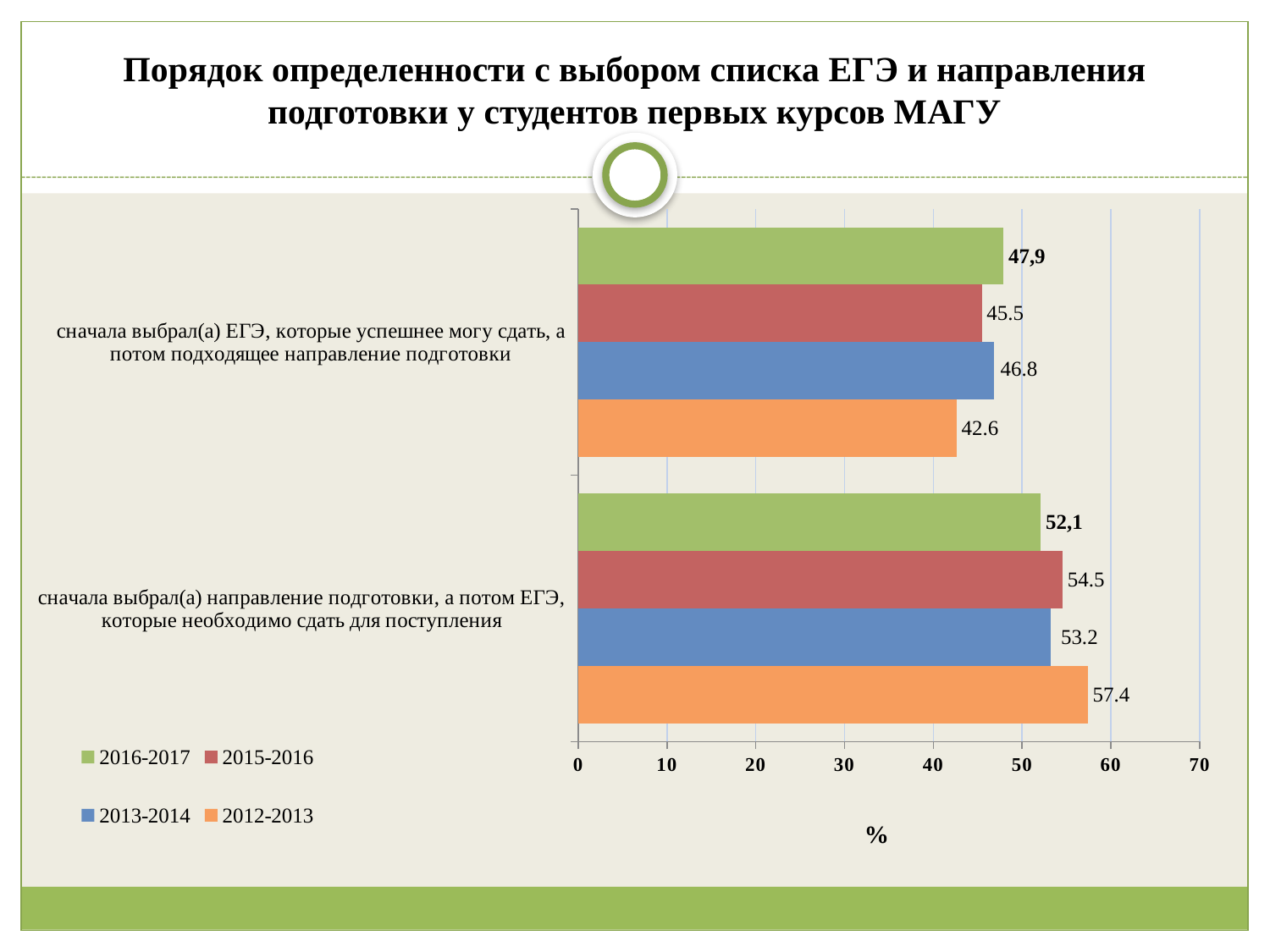
What kind of chart is shown on the slide? bar chart What is the value for 2016-2017 in the category "сначала выбрал(а) ЕГЭ, которые успешнее могу сдать, а потом подходящее направление подготовки"? 47,9 Which series has the highest value in the category "сначала выбрал(а) направление подготовки, а потом ЕГЭ, которые необходимо сдать для поступления"? 2012-2013 How many categories are shown on the vertical axis? 2 How many series does the legend list? 4 What unit is shown on the horizontal axis label? % What is the value for 2013-2014 in the category "сначала выбрал(а) ЕГЭ, которые успешнее могу сдать, а потом подходящее направление подготовки"? 46.8 What is the value for 2012-2013 in the category "сначала выбрал(а) направление подготовки, а потом ЕГЭ, которые необходимо сдать для поступления"? 57.4 Which series has the lowest value in the category "сначала выбрал(а) ЕГЭ, которые успешнее могу сдать, а потом подходящее направление подготовки"? 2012-2013 What is the difference between the 2012-2013 values for the two categories (57.4 and 42.6)? 14.8 Which is larger: the 2015-2016 value for "сначала выбрал(а) ЕГЭ..." or the 2015-2016 value for "сначала выбрал(а) направление подготовки..."? сначала выбрал(а) направление подготовки, а потом ЕГЭ, которые необходимо сдать для поступления What is the value for 2015-2016 in the category "сначала выбрал(а) направление подготовки, а потом ЕГЭ, которые необходимо сдать для поступления"? 54.5